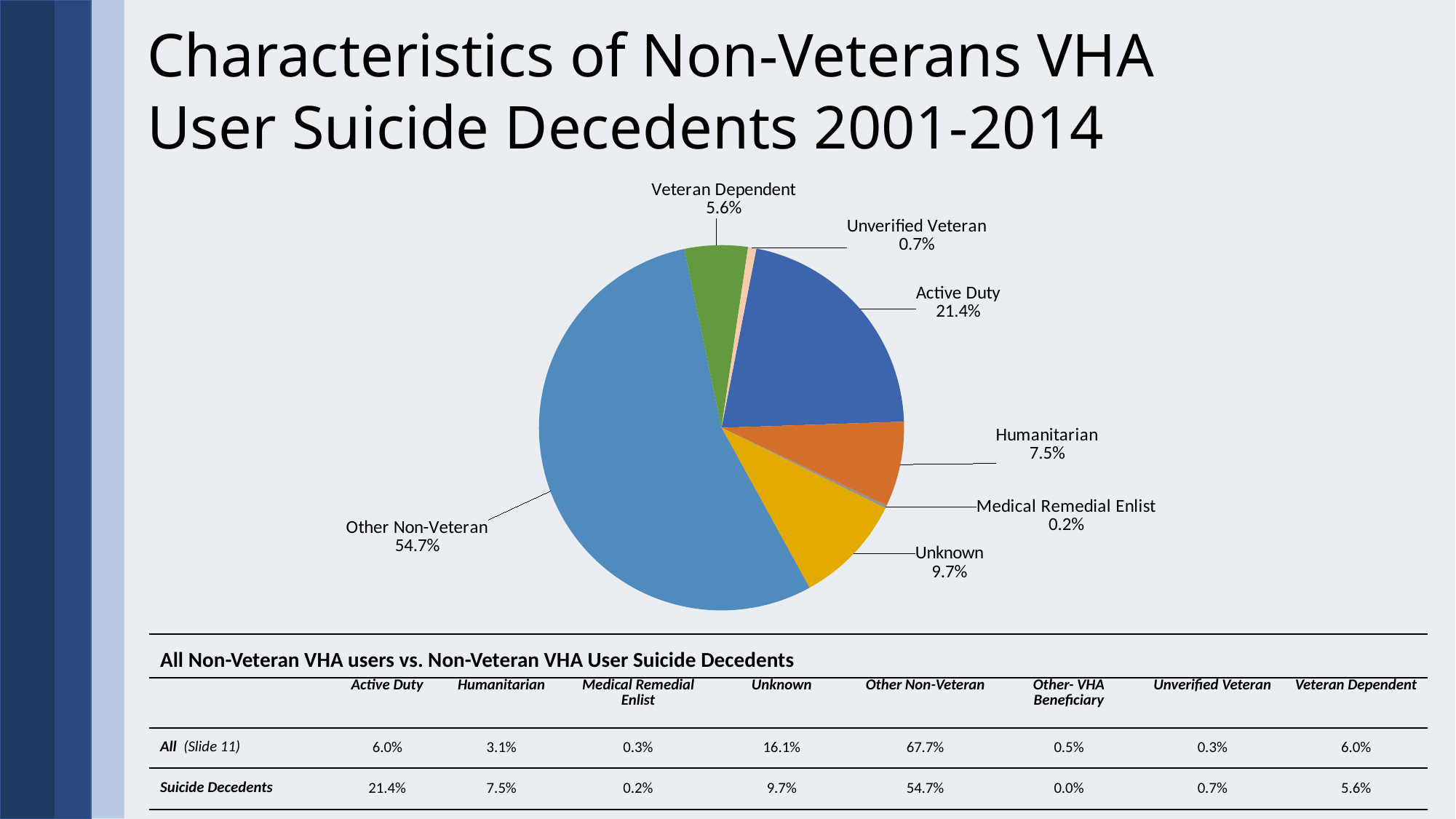
Which is larger in the pie chart, Veteran Dependent or Humanitarian? Humanitarian Which category has the smallest slice of the pie? Medical Remedial Enlist What is the value for Unknown in the pie chart? 9.7% How many labeled slices does the pie chart have? 7 What is the difference between the Veteran Dependent and Unverified Veteran percentages in the pie chart? 4.9% What share of the pie is Other Non-Veteran? 54.7% Which category has the largest slice of the pie? Other Non-Veteran What is the difference between the Active Duty and Unknown percentages in the pie chart? 11.7% What is the value for Humanitarian in the pie chart? 7.5% What is the value for Medical Remedial Enlist in the pie chart? 0.2% What kind of chart is shown on the slide? pie chart What is the value for Active Duty in the pie chart? 21.4%